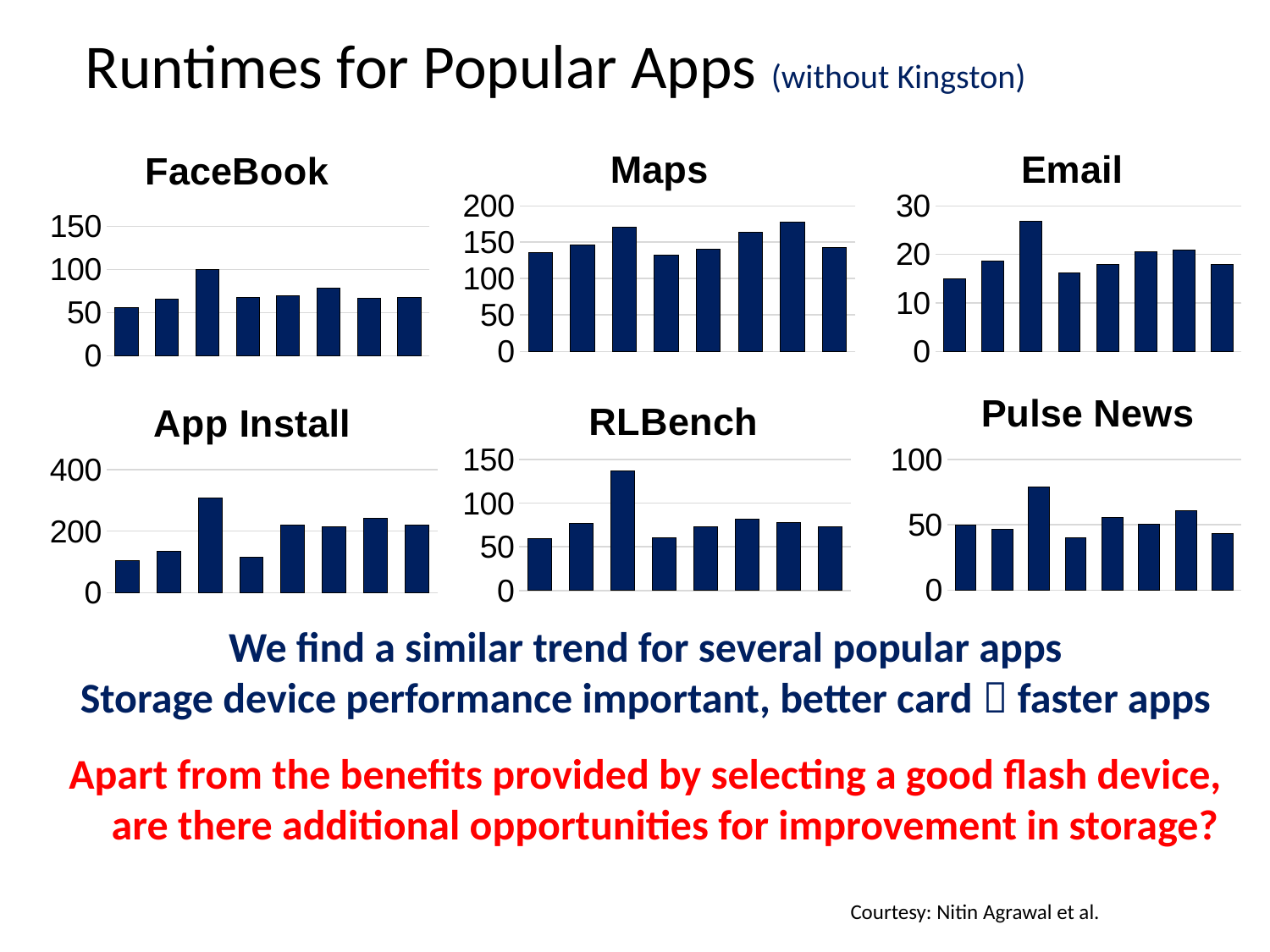
In the FaceBook chart, which bar (by position from the left) is the highest? the third bar In the App Install chart, which bar (by position from the left) is the highest? the third bar In the Maps chart, is the value of the seventh bar from the left greater or less than 150? greater In the FaceBook chart, which bar (by position from the left) is the lowest? the first bar In the App Install chart, is the value of the third bar from the left greater or less than 200? greater In the RLBench chart, which bar (by position from the left) is the highest? the third bar How many bars are plotted in the Maps chart? 8 How many charts are shown on the slide? 6 In the Email chart, is the value of the first bar from the left greater or less than 20? less How many bars are plotted in the Pulse News chart? 8 What kind of chart is the FaceBook chart? bar chart